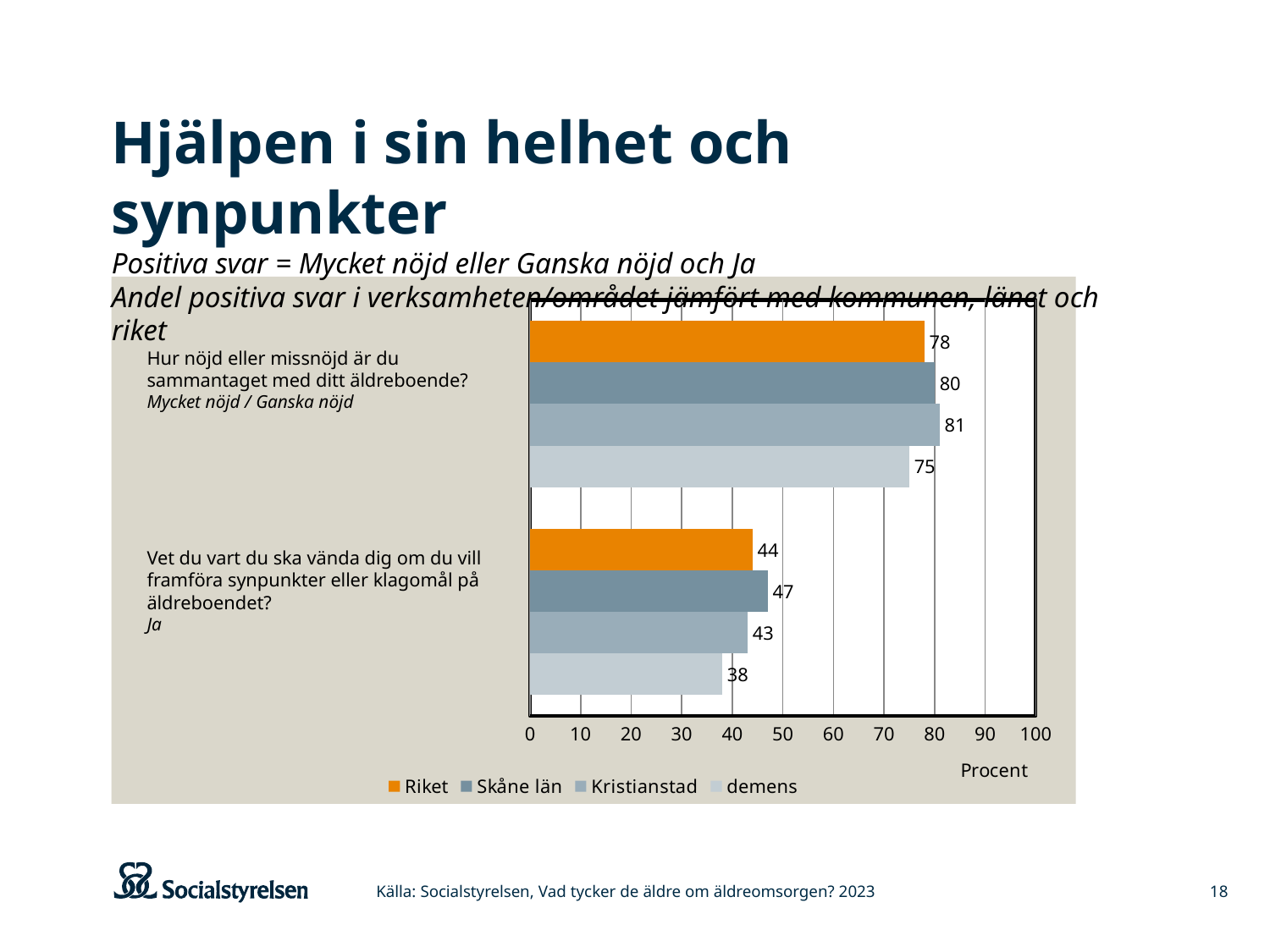
Which is larger on the question "Vet du vart du ska vända dig om du vill framföra synpunkter eller klagomål på äldreboendet?": Riket or Kristianstad? Riket What kind of chart is shown on the slide? bar chart What is the value for Riket on the question "Hur nöjd eller missnöjd är du sammantaget med ditt äldreboende?"? 78 Which series has the lowest value on the question "Vet du vart du ska vända dig om du vill framföra synpunkter eller klagomål på äldreboendet?"? demens What is the value for Skåne län on the question "Vet du vart du ska vända dig om du vill framföra synpunkter eller klagomål på äldreboendet?"? 47 What unit label is shown on the x axis of the chart? Procent How many question groups are plotted in the chart? 2 What is the difference between the Skåne län and demens values on the question "Hur nöjd eller missnöjd är du sammantaget med ditt äldreboende?"? 5 How many series does the chart legend list? 4 What is the value for Kristianstad on the question "Hur nöjd eller missnöjd är du sammantaget med ditt äldreboende?"? 81 What is the value for demens on the question "Vet du vart du ska vända dig om du vill framföra synpunkter eller klagomål på äldreboendet?"? 38 Which series has the highest value on the question "Hur nöjd eller missnöjd är du sammantaget med ditt äldreboende?"? Kristianstad